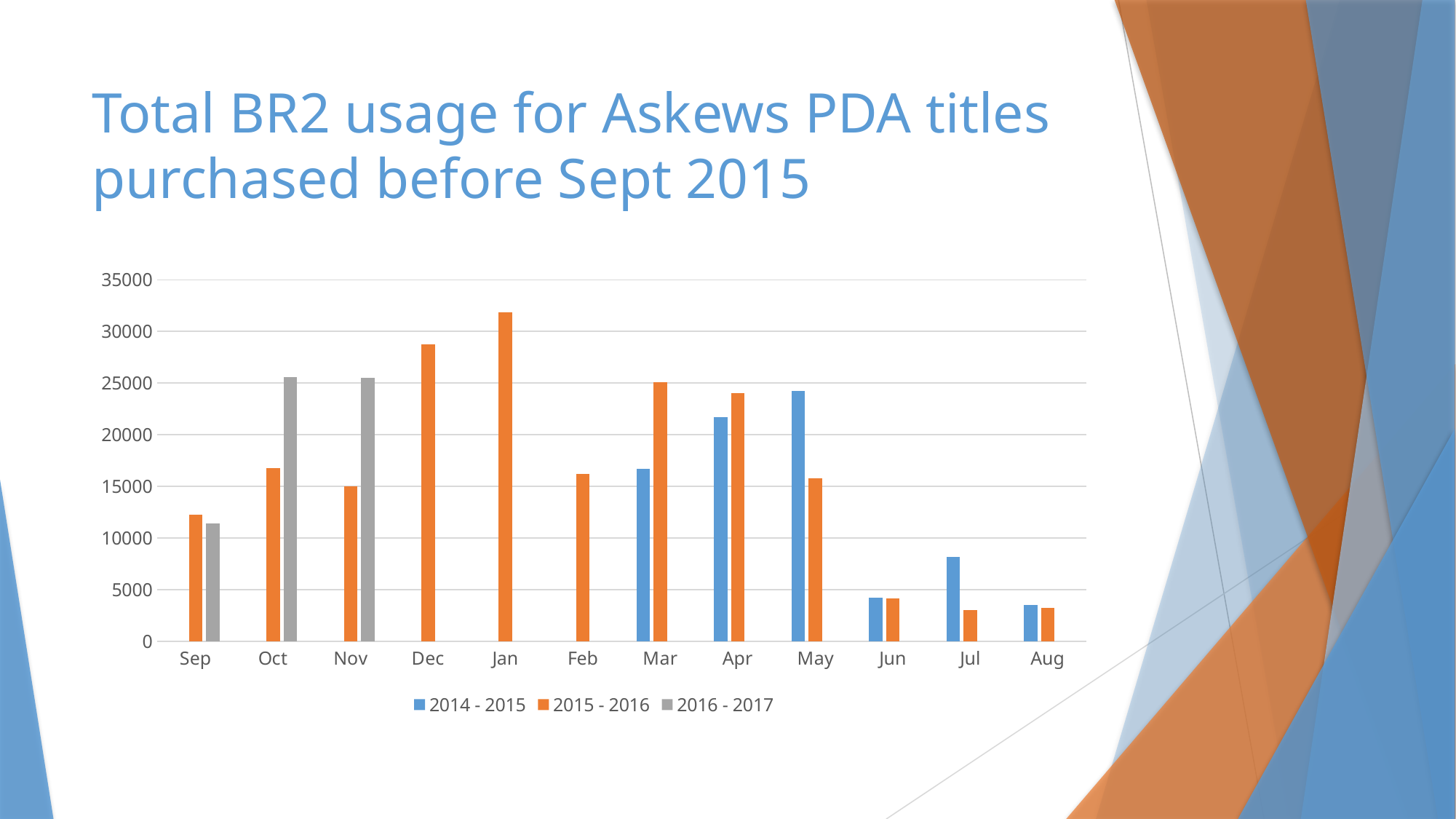
How many series does the legend list? 3 What kind of chart is shown on the slide? Bar chart In Oct, which series has the larger value: 2015 - 2016 or 2016 - 2017? 2016 - 2017 Do the 2015 - 2016 values rise or fall from May to Jul? Fall Is the 2015 - 2016 value for Jan greater or less than 30000? greater Is the 2016 - 2017 value for Oct greater or less than 20000? greater In which month is the 2015 - 2016 value highest? Jan In May, which series has the larger value: 2014 - 2015 or 2015 - 2016? 2014 - 2015 Is the 2014 - 2015 value for Jul greater or less than 10000? less How many months are shown on the x axis? 12 In which month is the 2014 - 2015 value highest? May What is the title of the chart? Total BR2 usage for Askews PDA titles purchased before Sept 2015